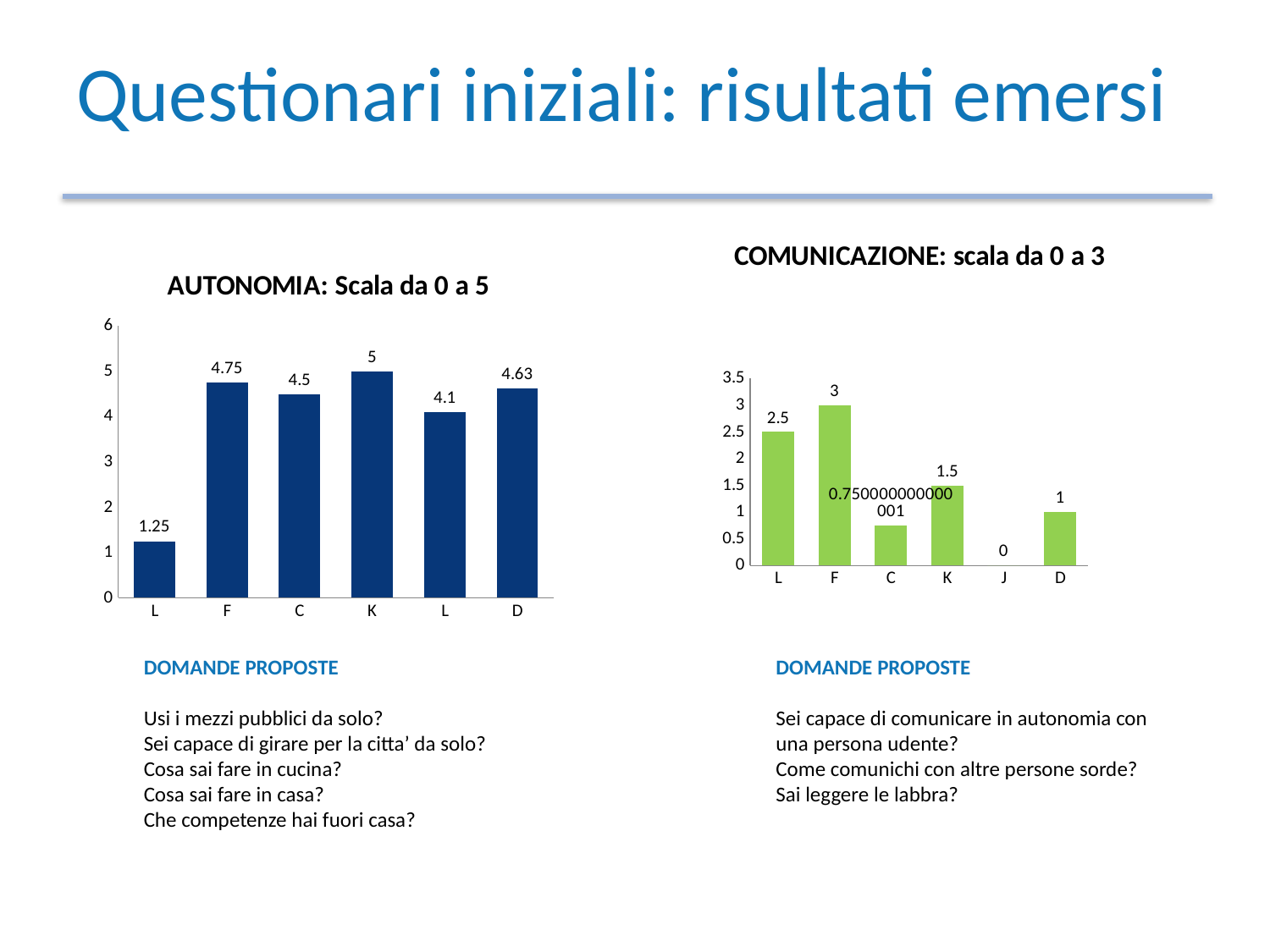
What kind of chart is the COMUNICAZIONE chart? Bar chart In the AUTONOMIA chart, what is the value for D? 4.63 In the COMUNICAZIONE chart, which is larger, the value for K or the value for D? K In the COMUNICAZIONE chart, which category has the lowest value? J In the COMUNICAZIONE chart, what is the value for L? 2.5 In the AUTONOMIA chart, which category has the highest value? K In the AUTONOMIA chart, which category has the lowest value? L In the AUTONOMIA chart, what is the difference between the values for F and C? 0.25 In the AUTONOMIA chart, what is the value for F? 4.75 How many bars are shown in the AUTONOMIA chart? 6 In the AUTONOMIA chart, what is the value for K? 5 In the COMUNICAZIONE chart, which category has the highest value? F